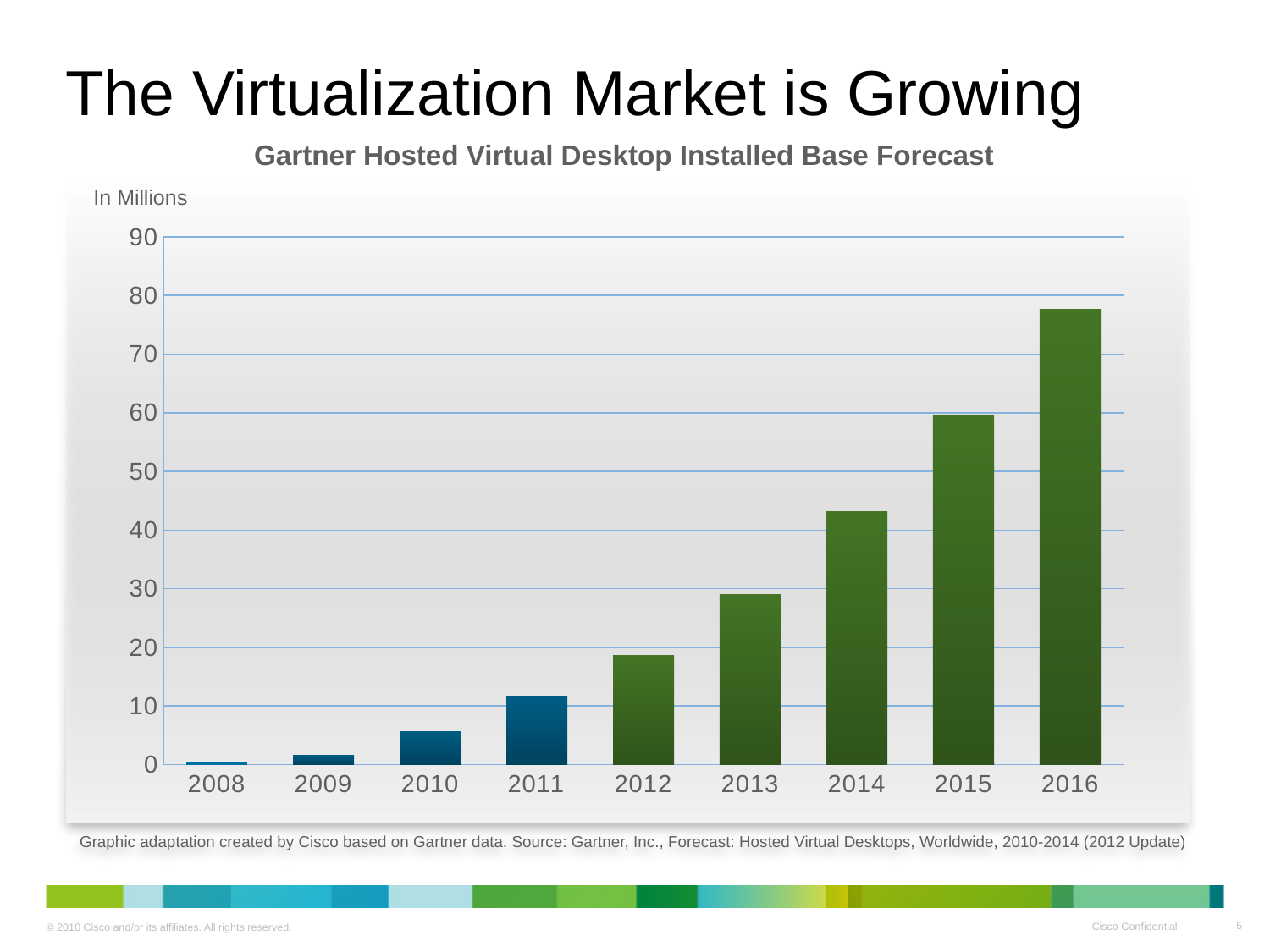
Is the value for 2011 greater or less than 20? less Which year has the highest value? 2016 Do the values rise or fall from 2008 to 2016? rise How many years are plotted on the x axis? 9 Is the value for 2013 greater or less than 40? less Which is larger, the value for 2012 or the value for 2014? 2014 What kind of chart is shown on the slide? bar chart What is the title of the chart? Gartner Hosted Virtual Desktop Installed Base Forecast Is the value for 2014 greater or less than 40? greater Which year has the lowest value? 2008